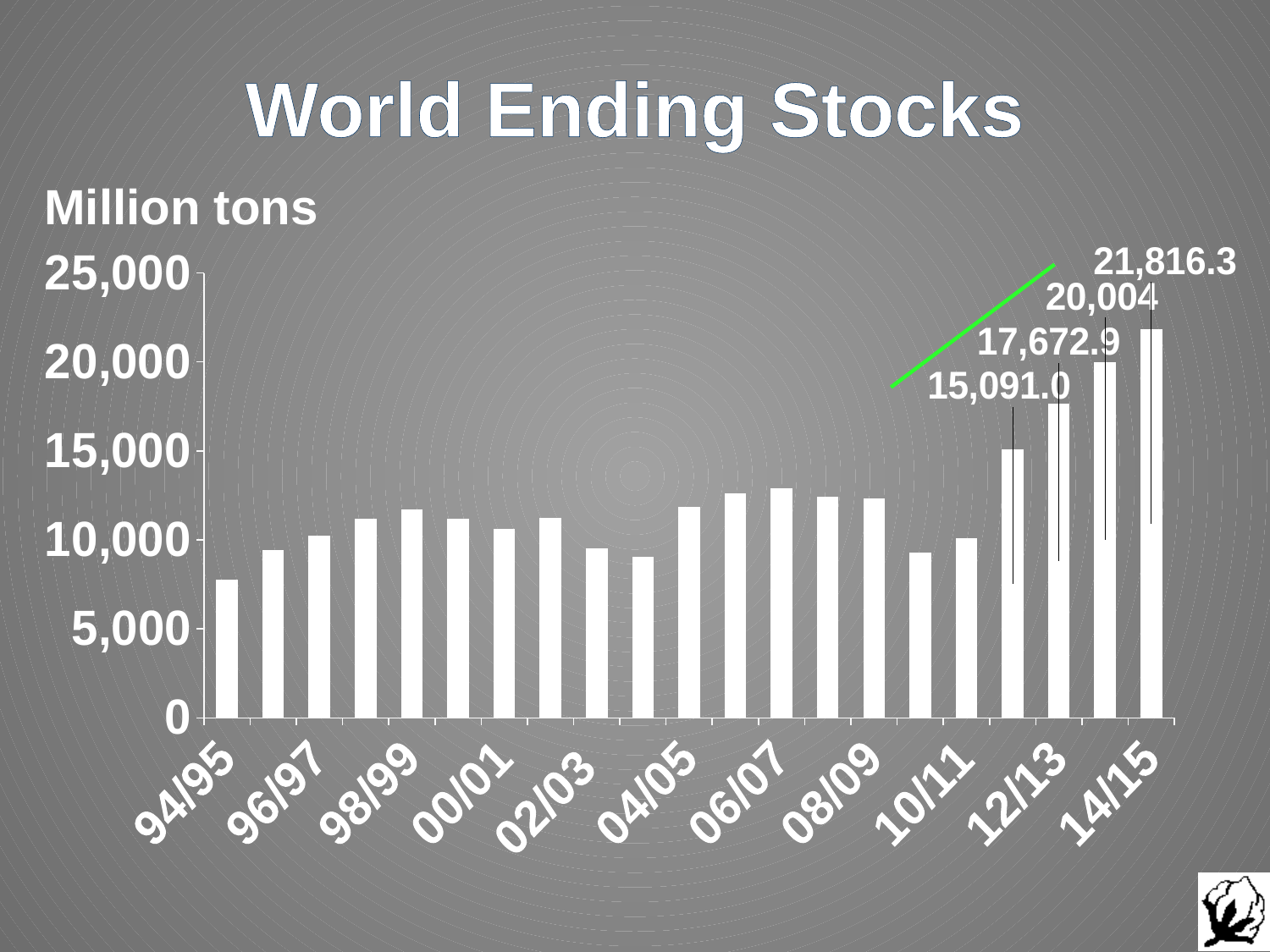
Is the value for 94/95 greater or less than 10,000? less Is the value for 06/07 greater or less than 10,000? greater What kind of chart is shown? bar chart Do the values rise or fall from 10/11 to 14/15? rise Which year has the highest ending stocks? 14/15 What is the value for 14/15? 21,816.3 Which is larger, the value for 94/95 or the value for 96/97? 96/97 How many bars are plotted in the chart? 21 What is the difference between the values for 14/15 and 12/13? 4,143.3 What unit is shown above the y axis? Million tons What is the value for 12/13? 17,672.9 Which year has the lowest ending stocks? 94/95